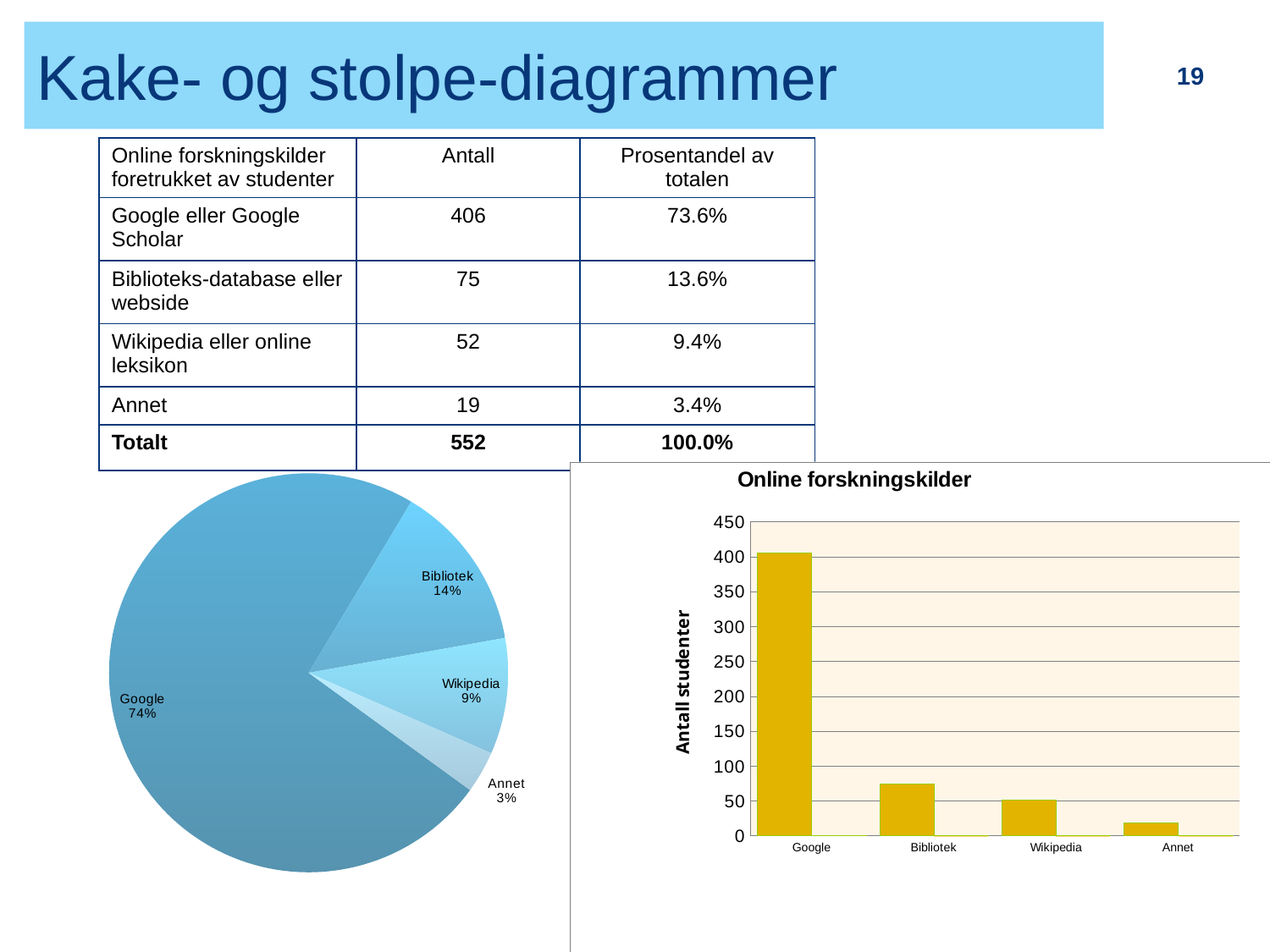
What kind of chart is the chart on the left of the slide? pie chart What kind of chart is the chart titled 'Online forskningskilder' on the right? bar chart In the pie chart on the left, what share does the Annet slice represent? 3% In the bar chart 'Online forskningskilder', which category has the highest bar? Google In the bar chart 'Online forskningskilder', what is the label of the y axis? Antall studenter In the pie chart on the left, how many slices are there? 4 In the pie chart on the left, which slice is the smallest? Annet In the pie chart on the left, what share does the Bibliotek slice represent? 14% In the pie chart on the left, what share does the Wikipedia slice represent? 9% In the bar chart 'Online forskningskilder', is the value for Bibliotek greater or less than 100? less